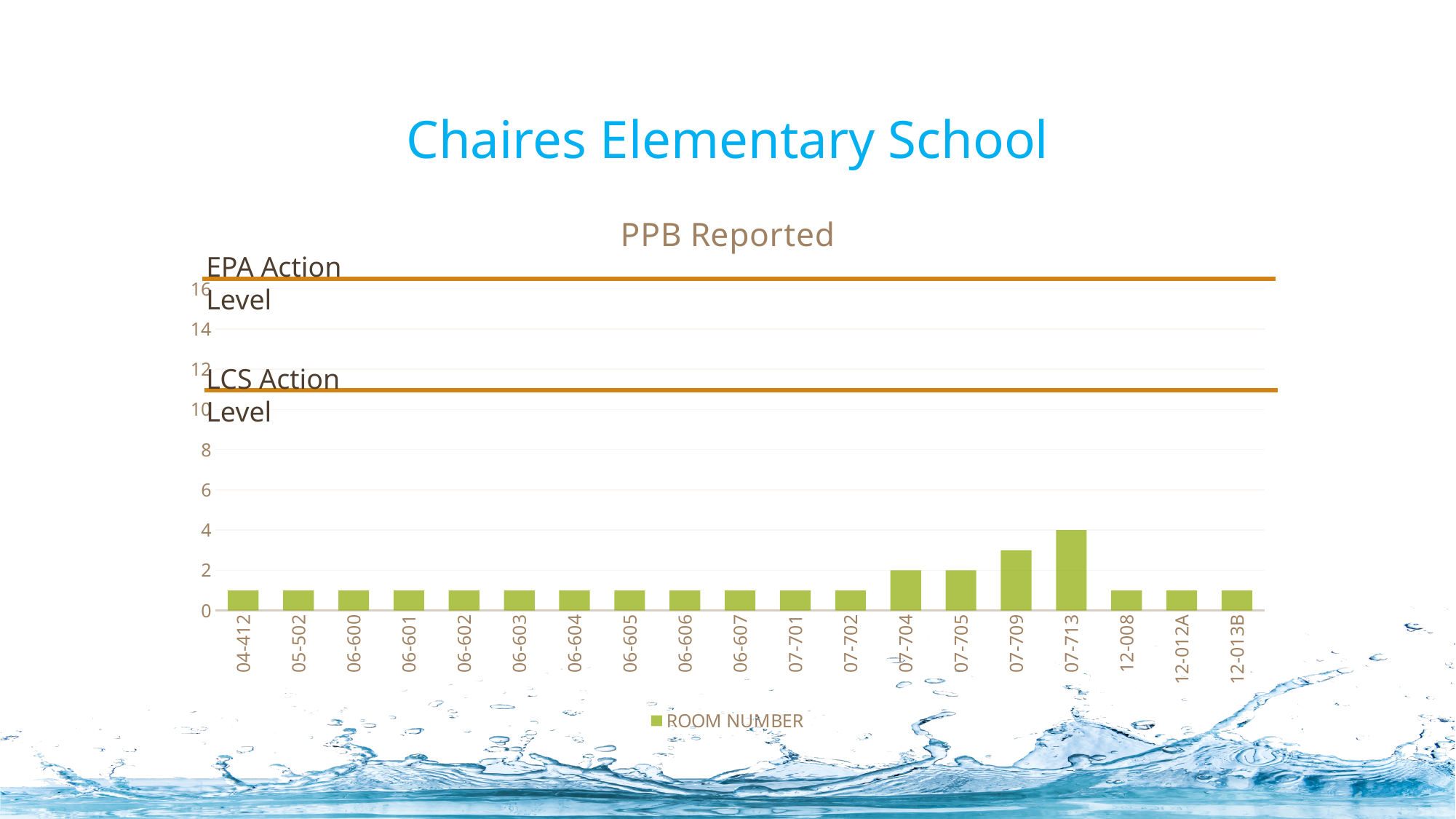
Which has a larger value, room 07-709 or room 07-713? 07-713 What is the title of the chart? PPB Reported Which room number has the highest PPB reported value? 07-713 What is the PPB reported value for room 07-713? 4 Is the value for room 06-603 greater or less than 2? less Is the value for room 07-709 greater or less than 2? greater What is the PPB reported value for room 07-704? 2 What kind of chart is shown on the slide? bar chart Which has a larger value, room 05-502 or room 07-709? 07-709 What is the difference between the values for room 07-713 and room 07-705? 2 How many series does the legend list? 1 How many room numbers are shown on the x axis of the chart? 19